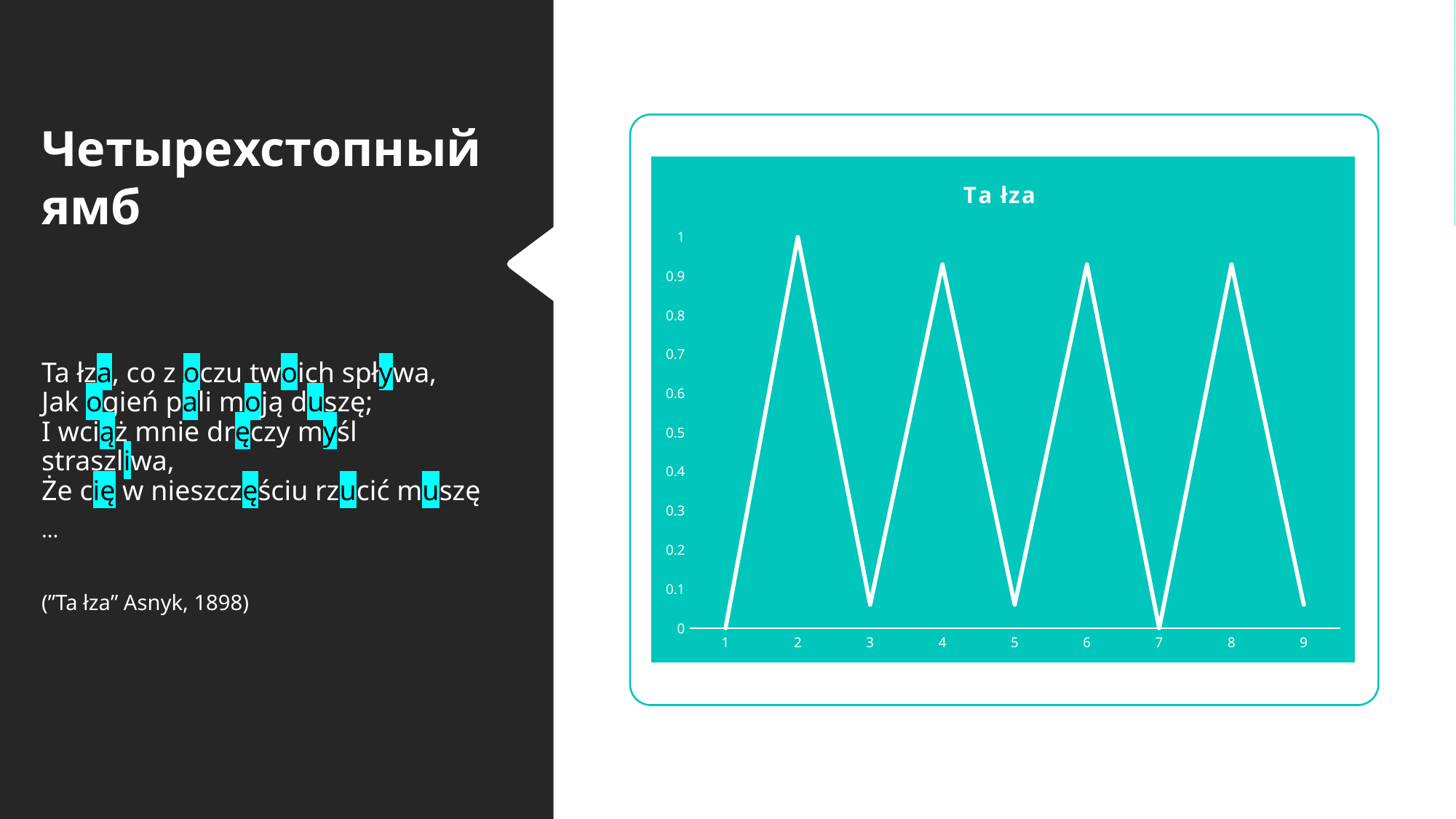
Which has the larger value, point 6 or point 5? point 6 What is the value at point 2 on the chart? 1 What is the value at point 1 on the chart? 0 Is the value at point 9 greater or less than 0.2? less What kind of chart is shown on the slide? line chart Is the value at point 4 greater or less than 0.5? greater What is the value at point 7 on the chart? 0 Which point on the x axis has the highest value? 2 How many points are plotted along the x axis of the chart? 9 What is the difference between the value at point 2 and the value at point 1? 1 What is the title of the chart? Ta łza Is the value at point 3 greater or less than 0.5? less